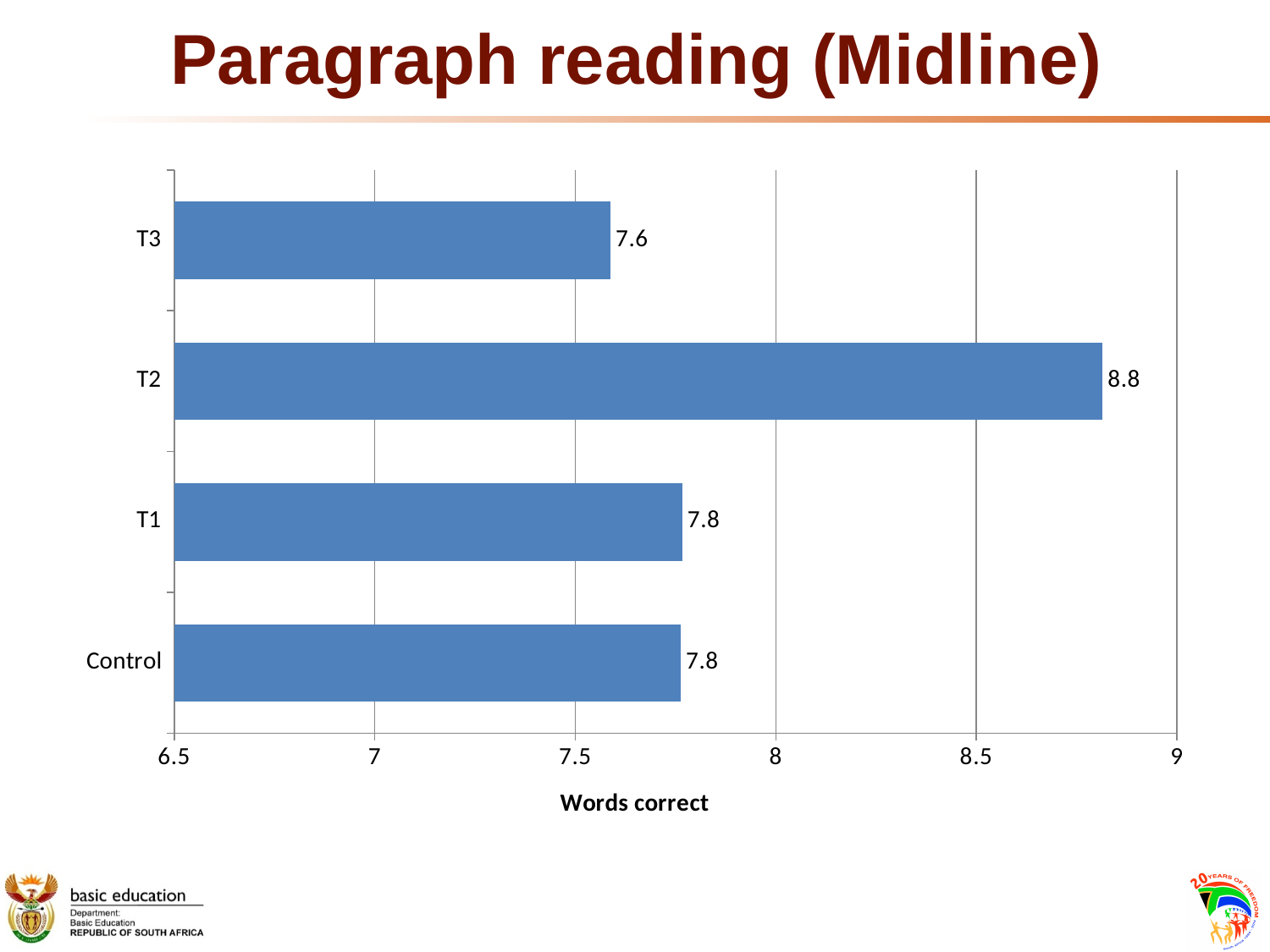
What is the difference between the values for T2 and T3? 1.2 Which category has the highest value? T2 What is the difference between the values for T1 and T3? 0.2 What is the value for T3? 7.6 What is the value for T2? 8.8 What is the value for Control? 7.8 What is the label of the horizontal axis? Words correct Which is larger, the value for T2 or the value for T1? T2 Is the value for T2 greater or less than 8.5? greater Which category has the lowest value? T3 What kind of chart is shown on the slide? bar chart How many categories are shown in the chart? 4